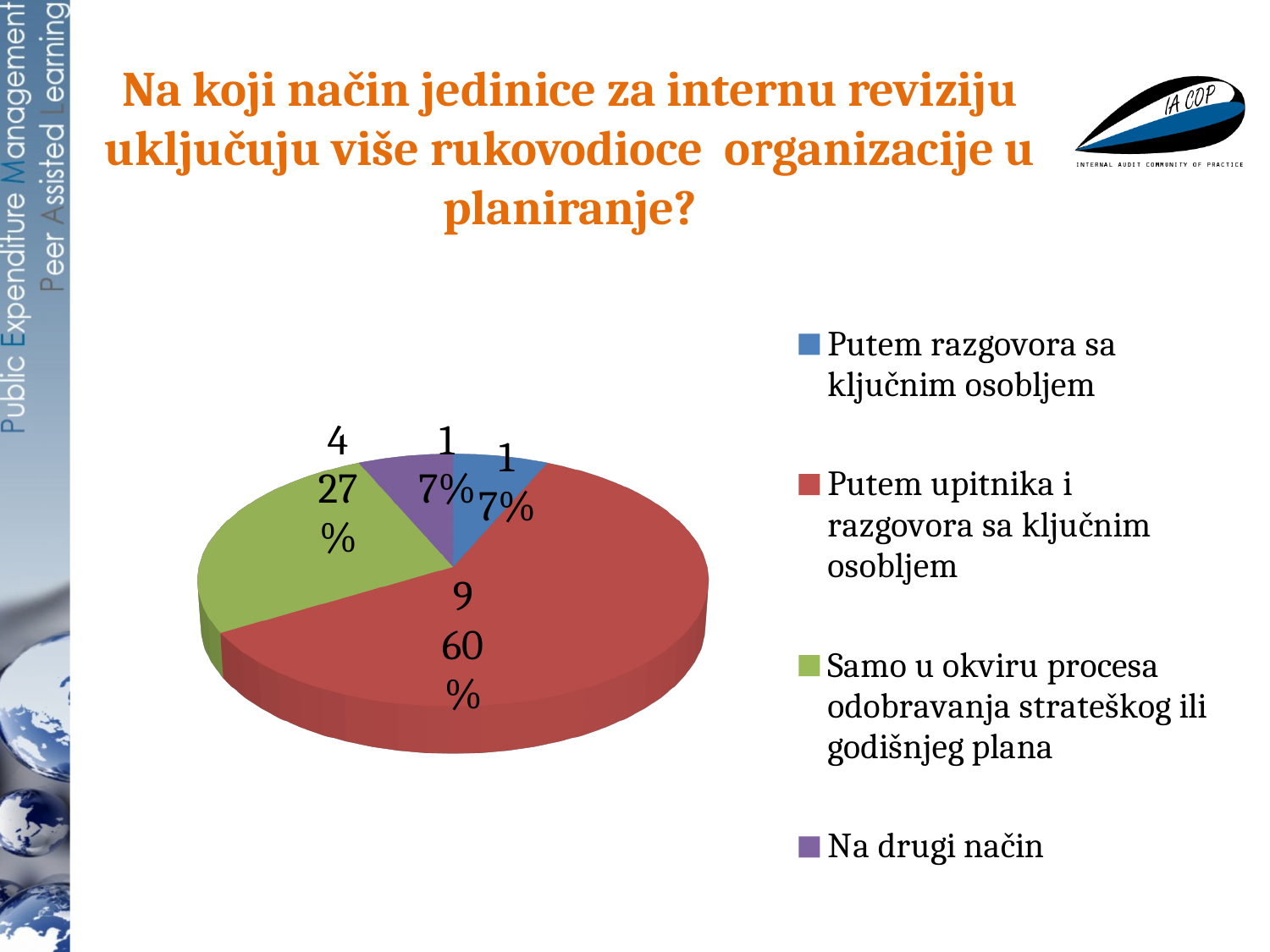
How many slices does the pie chart have? 4 What kind of chart is shown on the slide? pie chart What is the count shown for "Putem upitnika i razgovora sa ključnim osobljem"? 9 What is the difference in count between "Putem upitnika i razgovora sa ključnim osobljem" and "Samo u okviru procesa odobravanja strateškog ili godišnjeg plana"? 5 What is the count shown for "Samo u okviru procesa odobravanja strateškog ili godišnjeg plana"? 4 How many entries does the legend list? 4 Which colour represents "Na drugi način" in the pie chart? purple What percentage share does "Na drugi način" have? 7% What percentage share does "Samo u okviru procesa odobravanja strateškog ili godišnjeg plana" have? 27% What is the count shown for "Putem razgovora sa ključnim osobljem"? 1 What percentage share does "Putem upitnika i razgovora sa ključnim osobljem" have? 60% Which category has the largest slice of the pie? Putem upitnika i razgovora sa ključnim osobljem